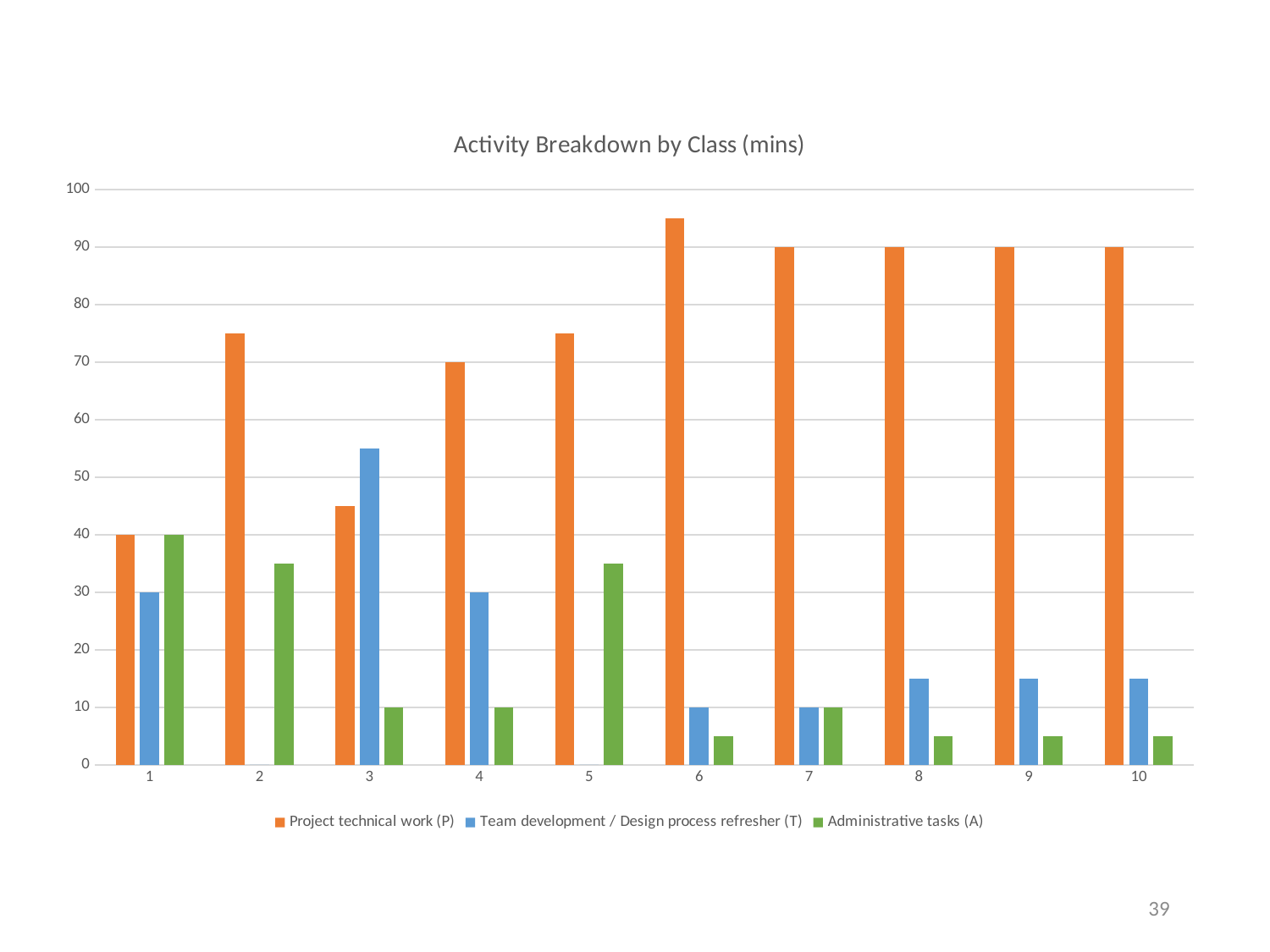
Which class has the highest value for Project technical work (P)? 6 Which class has the lowest value for Project technical work (P)? 1 What is the value of Team development / Design process refresher (T) for class 1? 30 What is the title of the chart? Activity Breakdown by Class (mins) What is the value of Project technical work (P) for class 4? 70 What type of chart is shown on the slide? Bar chart What is the difference between Project technical work (P) and Team development / Design process refresher (T) for class 7? 80 Is the value of Team development / Design process refresher (T) for class 3 greater or less than 50? greater How many series does the legend list? 3 What is the value of Project technical work (P) for class 1? 40 What is the value of Project technical work (P) for class 7? 90 How many classes are shown along the x axis? 10